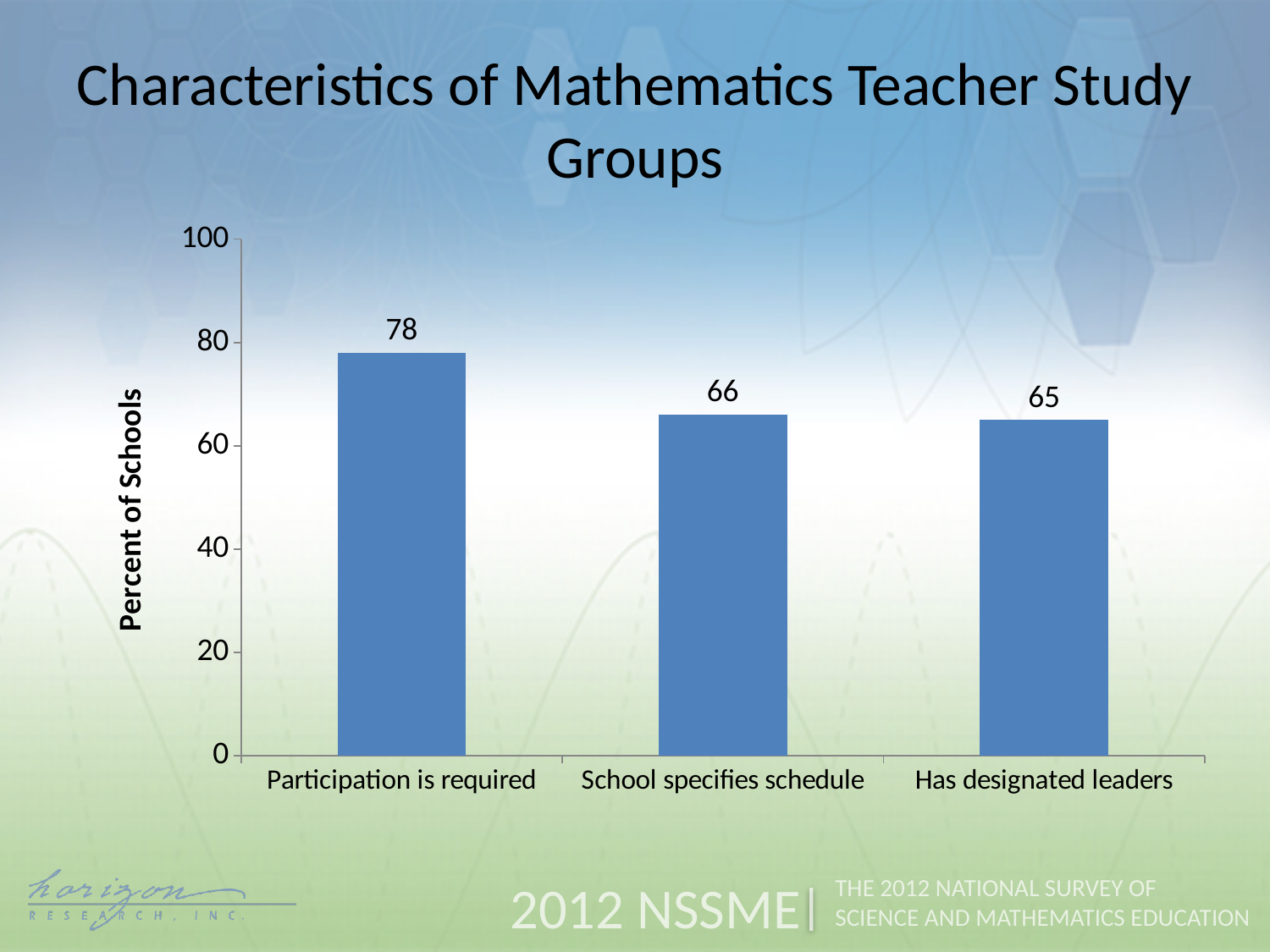
Which characteristic has the lowest percent of schools? Has designated leaders What percent of schools report that participation is required? 78 Is the value for 'School specifies schedule' greater or less than 60? greater Which characteristic has the highest percent of schools? Participation is required How many categories are shown in the chart? 3 What is the difference between the values for 'Participation is required' and 'Has designated leaders'? 13 Which is larger: the value for 'Participation is required' or 'School specifies schedule'? Participation is required What is the label of the vertical axis? Percent of Schools What is the value for 'School specifies schedule'? 66 What type of chart is shown on the slide? Bar chart What is the difference between the values for 'Participation is required' and 'School specifies schedule'? 12 What is the value for 'Has designated leaders'? 65